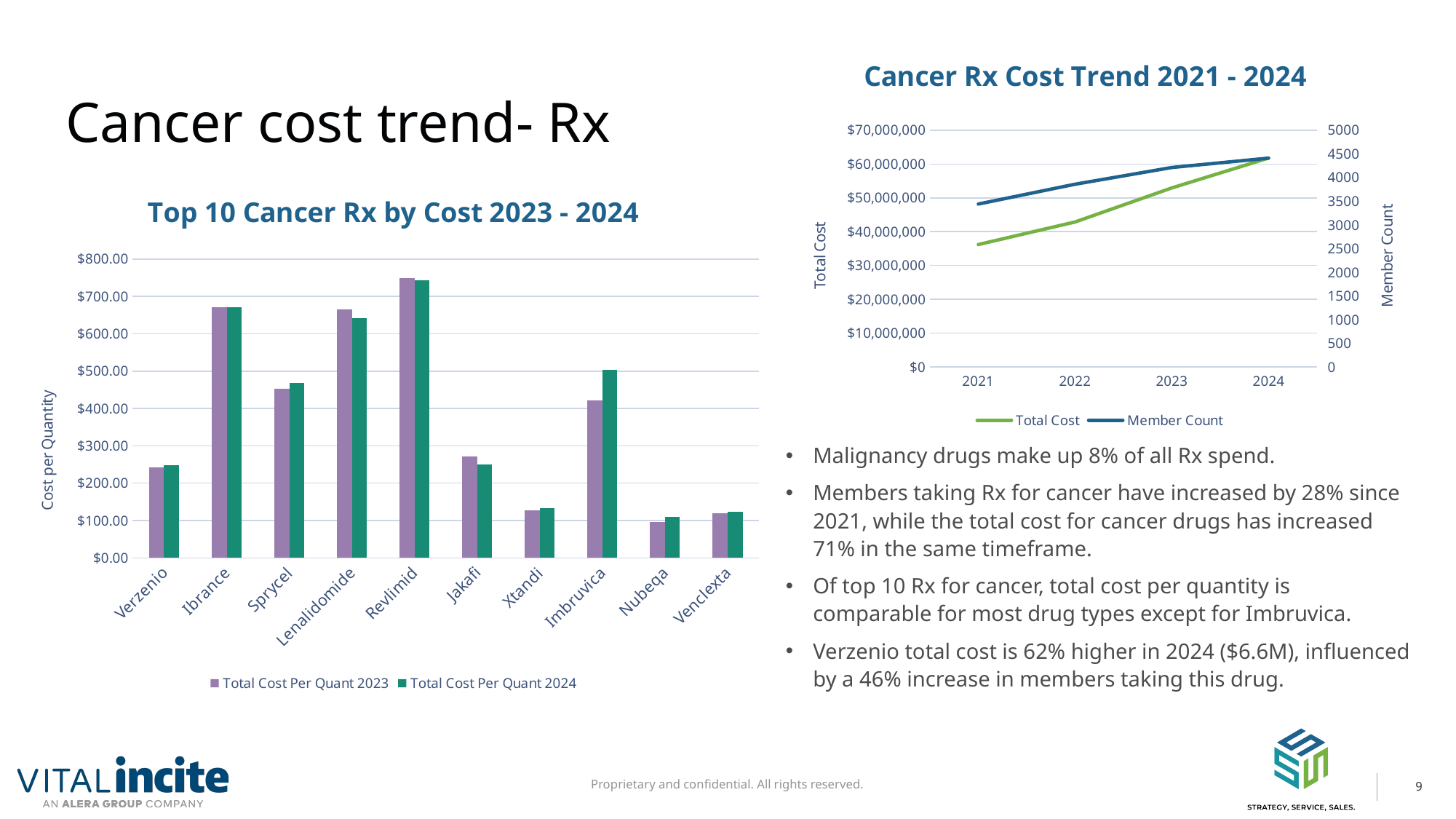
In "Top 10 Cancer Rx by Cost 2023 - 2024", which is larger for Imbruvica: Total Cost Per Quant 2023 or Total Cost Per Quant 2024? Total Cost Per Quant 2024 In "Top 10 Cancer Rx by Cost 2023 - 2024", is the Total Cost Per Quant 2023 for Jakafi greater or less than $300.00? less What type of chart is "Cancer Rx Cost Trend 2021 - 2024"? Line chart In "Cancer Rx Cost Trend 2021 - 2024", does Total Cost rise or fall from 2021 to 2024? Rise In "Top 10 Cancer Rx by Cost 2023 - 2024", is the Total Cost Per Quant 2024 for Imbruvica greater or less than $400.00? greater What type of chart is "Top 10 Cancer Rx by Cost 2023 - 2024"? Bar chart In "Top 10 Cancer Rx by Cost 2023 - 2024", how many drugs are shown on the x axis? 10 In "Top 10 Cancer Rx by Cost 2023 - 2024", which drug has the lowest Total Cost Per Quant 2023? Nubeqa In "Top 10 Cancer Rx by Cost 2023 - 2024", which drug has the highest Total Cost Per Quant 2024? Revlimid In "Top 10 Cancer Rx by Cost 2023 - 2024", which drug has a higher Total Cost Per Quant 2024: Sprycel or Xtandi? Sprycel In "Top 10 Cancer Rx by Cost 2023 - 2024", how many series does the legend list? 2 In "Cancer Rx Cost Trend 2021 - 2024", is the Total Cost for 2021 greater or less than $40,000,000? less